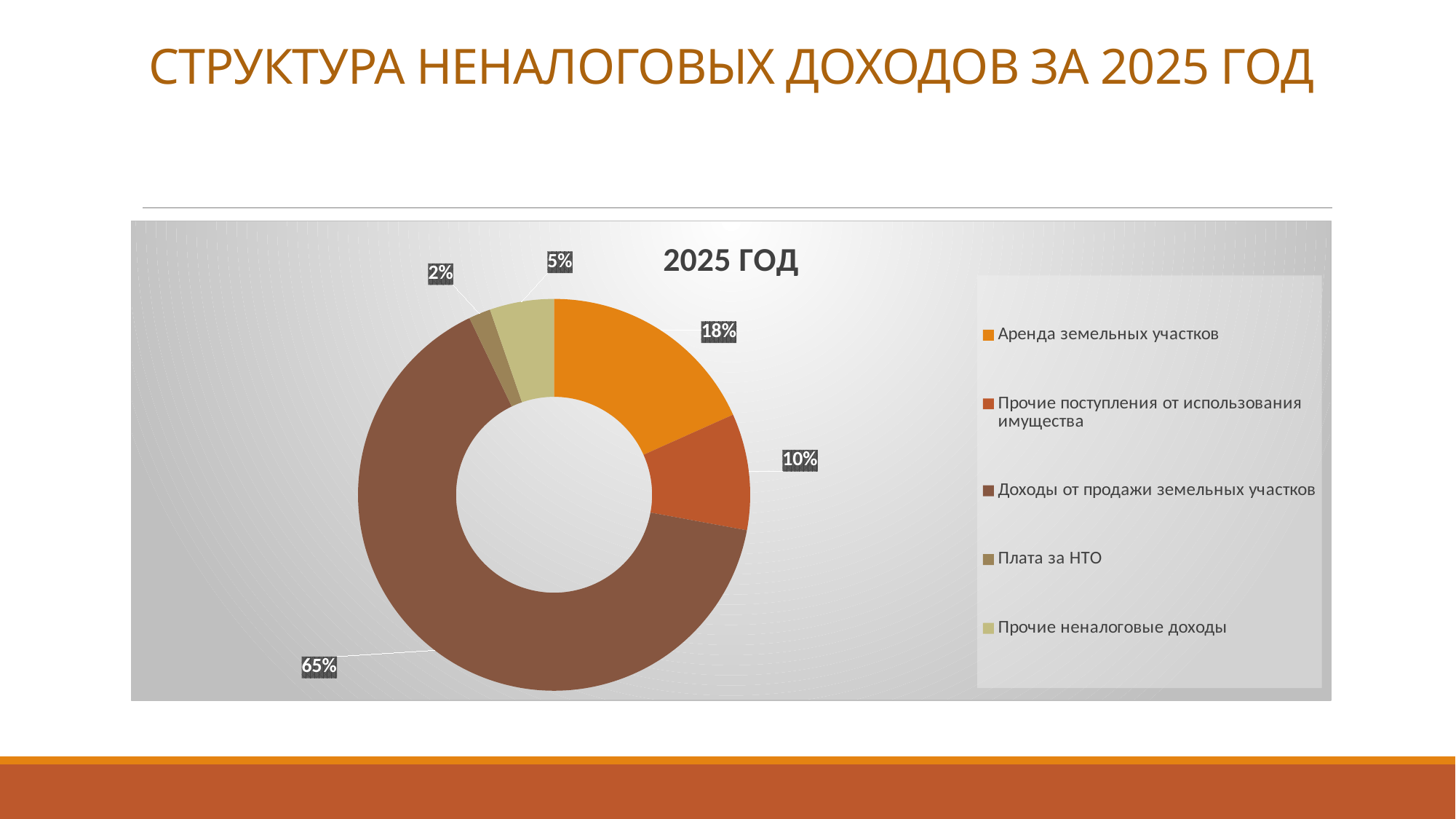
Какую долю составляют «Прочие неналоговые доходы»? 5% Какую долю составляет «Плата за НТО»? 2% Какую долю составляют «Доходы от продажи земельных участков»? 65% На сколько процентных пунктов доля «Доходы от продажи земельных участков» больше доли «Аренда земельных участков»? 47 Какая категория имеет наибольшую долю на диаграмме? Доходы от продажи земельных участков Какая категория имеет наименьшую долю на диаграмме? Плата за НТО Какой заголовок у диаграммы? 2025 ГОД Какой тип диаграммы показан на слайде? Кольцевая (круговая) диаграмма Сколько категорий показано на диаграмме? 5 Что больше: доля «Аренда земельных участков» или доля «Прочие поступления от использования имущества»? Аренда земельных участков Какую долю составляют «Прочие поступления от использования имущества»? 10% Какую долю составляет «Аренда земельных участков» на диаграмме? 18%